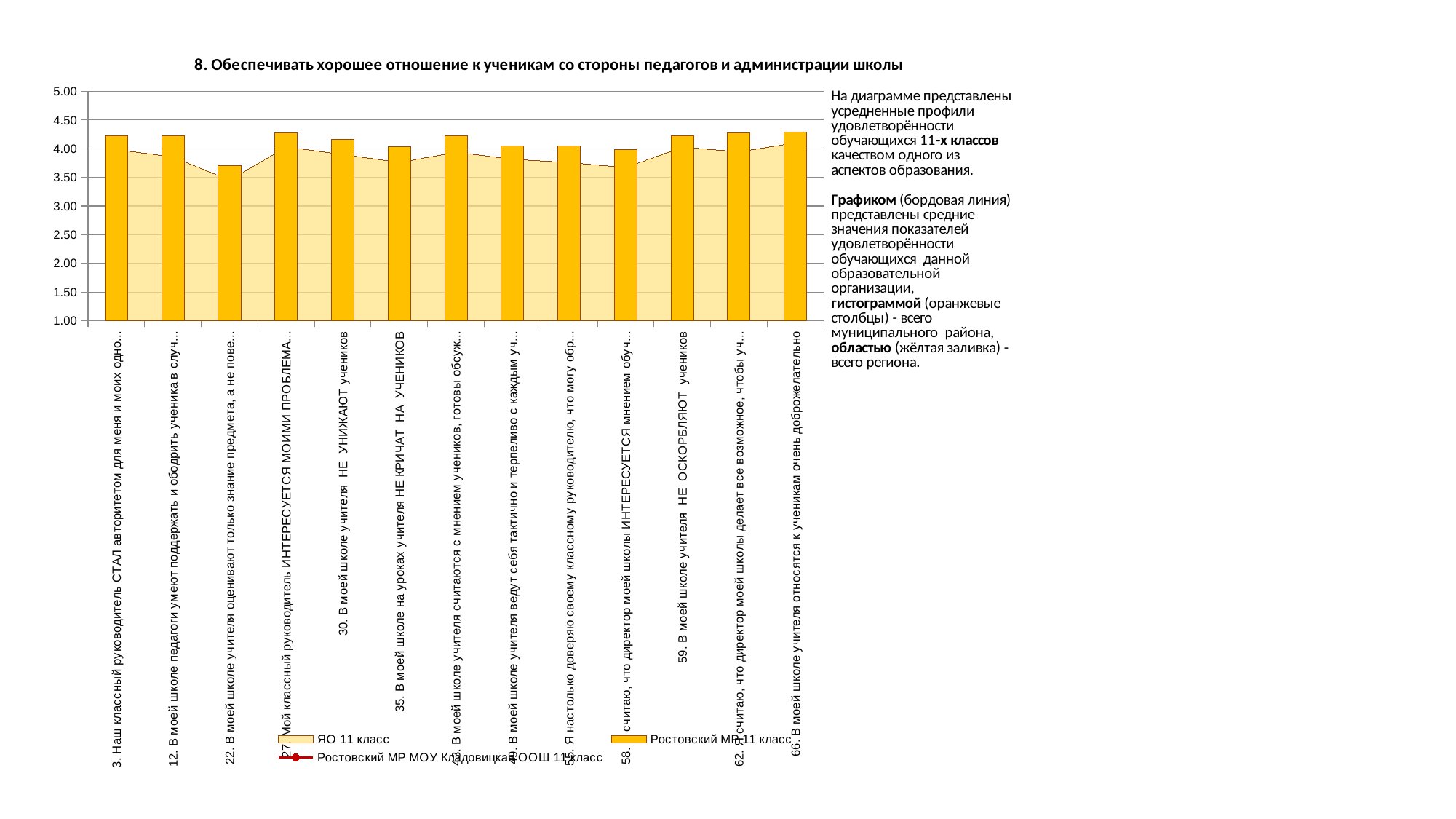
What kind of chart is this? combination bar and area chart Is the Ростовский МР 11 класс value for "30. В моей школе учителя НЕ УНИЖАЮТ учеников" greater or less than 4.00? greater Is the Ростовский МР 11 класс value for "66. В моей школе учителя относятся к ученикам очень доброжелательно" greater or less than 4.00? greater How many categories are plotted along the x axis? 13 Which has the larger Ростовский МР 11 класс value: "22. В моей школе учителя оценивают только знание предмета..." or "30. В моей школе учителя НЕ УНИЖАЮТ учеников"? 30. В моей школе учителя НЕ УНИЖАЮТ учеников Is the Ростовский МР 11 класс value for "22. В моей школе учителя оценивают только знание предмета..." greater or less than 4.00? less Which category has the lowest Ростовский МР 11 класс bar? 22. В моей школе учителя оценивают только знание предмета, а не пове… What colour are the bars for the Ростовский МР 11 класс series? orange How many series does the legend list? 3 What is the title of the chart? 8. Обеспечивать хорошее отношение к ученикам со стороны педагогов и администрации школы